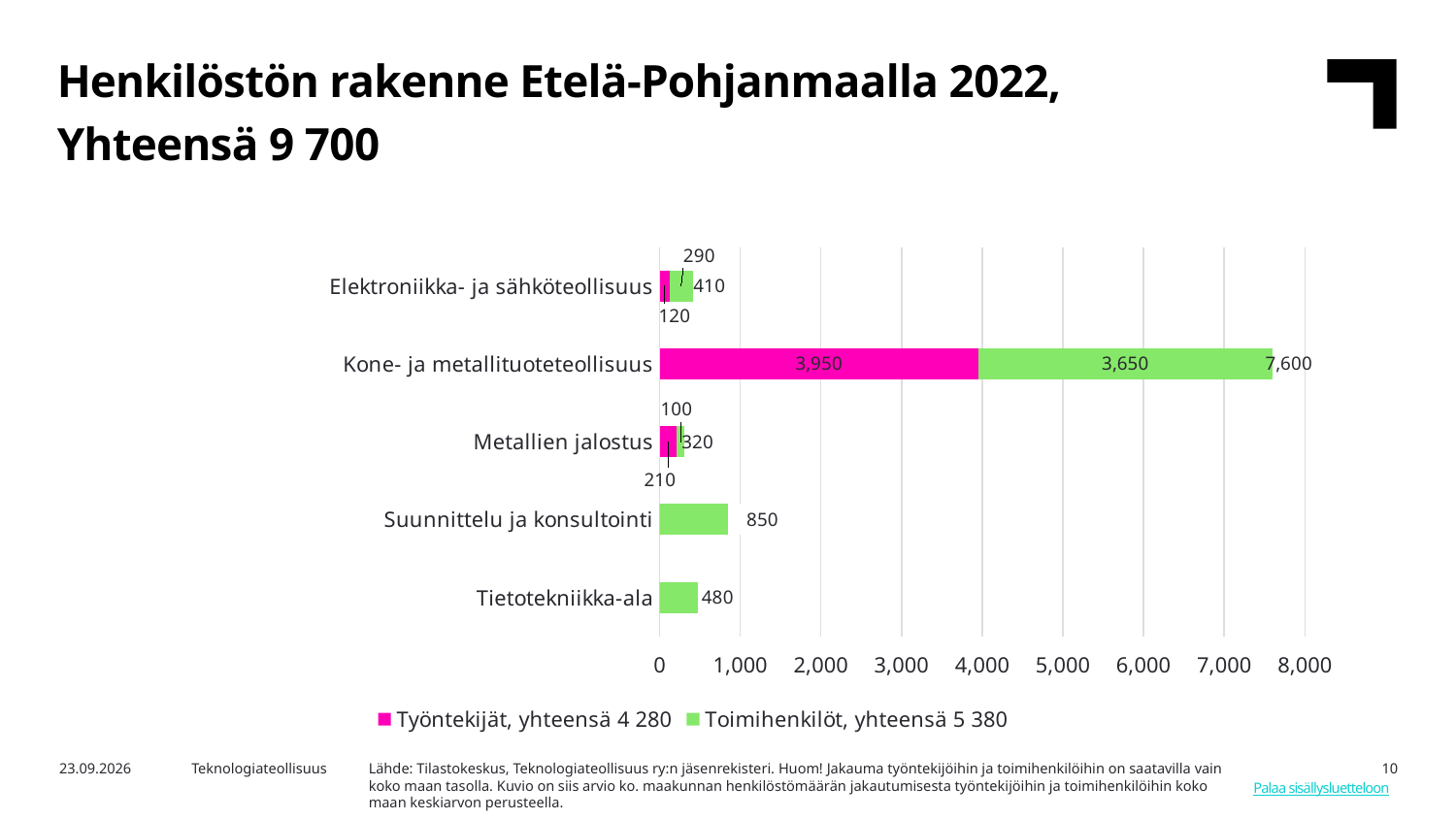
What total is given in the legend for Toimihenkilöt? 5 380 What is the Toimihenkilöt value for Kone- ja metallituoteteollisuus? 3,650 How many categories are shown on the chart? 5 What is the Työntekijät value for Kone- ja metallituoteteollisuus? 3,950 How many series does the legend list? 2 What is the total for the Kone- ja metallituoteteollisuus bar? 7,600 What is the value for Tietotekniikka-ala? 480 What is the value for Suunnittelu ja konsultointi? 850 Which category has the highest total? Kone- ja metallituoteteollisuus Which is larger, the value for Suunnittelu ja konsultointi or the value for Tietotekniikka-ala? Suunnittelu ja konsultointi What type of chart is shown on the slide? stacked bar chart What is the difference between the Työntekijät and Toimihenkilöt values for Kone- ja metallituoteteollisuus? 300